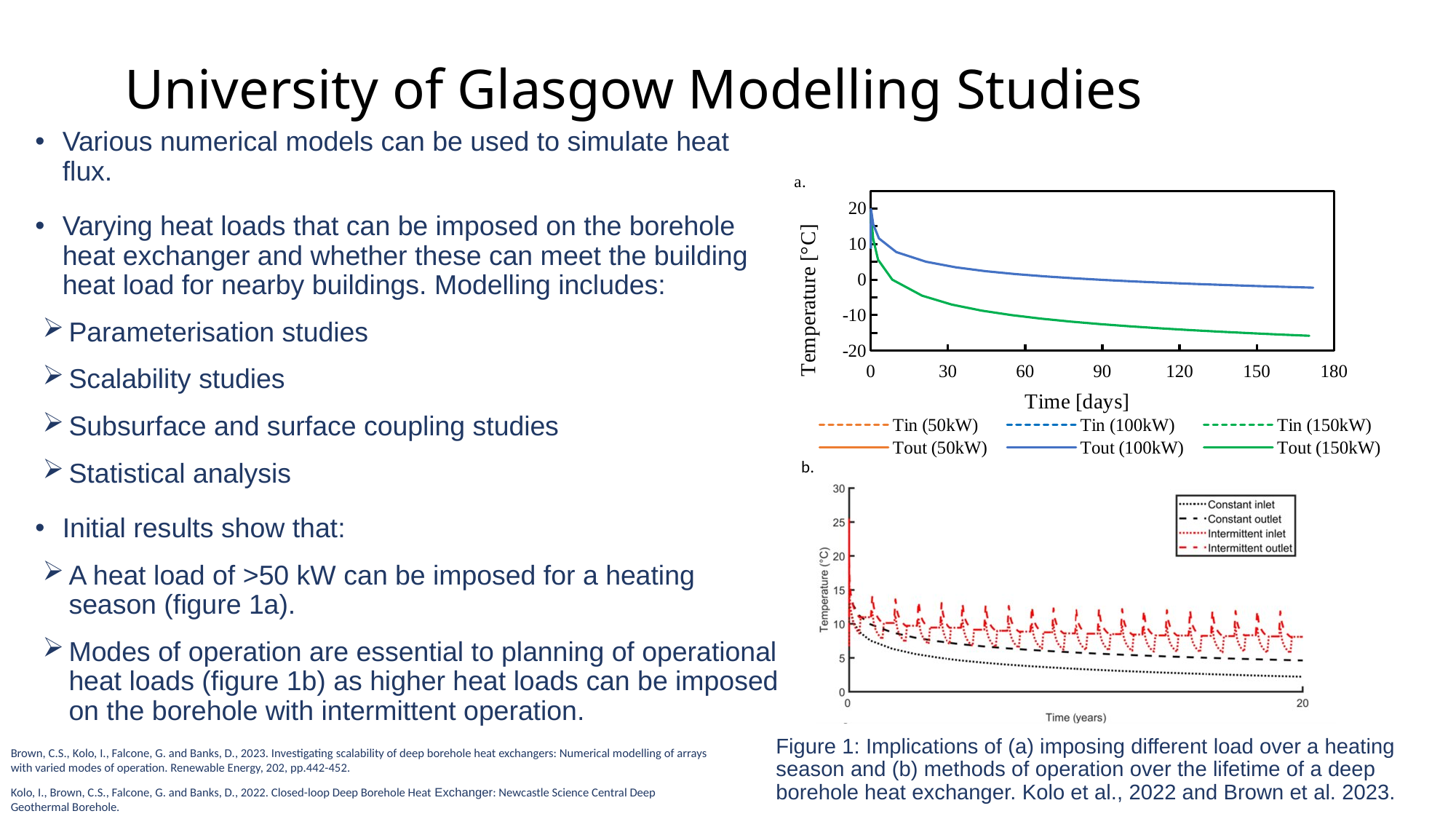
What kind of chart is chart b (the bottom chart)? line chart How many series does the legend of chart a (the top chart) list? 6 In chart a (the top chart), is the Tout (150kW) value at 150 days greater or less than -10? less What is the x-axis label of chart a (the top chart)? Time [days] In chart b (the bottom chart), is the Constant inlet value at 20 years greater or less than 5? less In chart b (the bottom chart), which is higher at 20 years, Constant inlet or Constant outlet? Constant outlet In chart a (the top chart), does the Tout (150kW) line rise or fall as time increases? fall In chart b (the bottom chart), does the Constant inlet line rise or fall over time? fall How many series does the legend of chart b (the bottom chart) list? 4 What kind of chart is chart a (the top chart)? line chart In chart a (the top chart), is the Tout (100kW) value at 150 days greater or less than -10? greater In chart a (the top chart), which line is higher at 150 days, Tout (100kW) or Tout (150kW)? Tout (100kW)